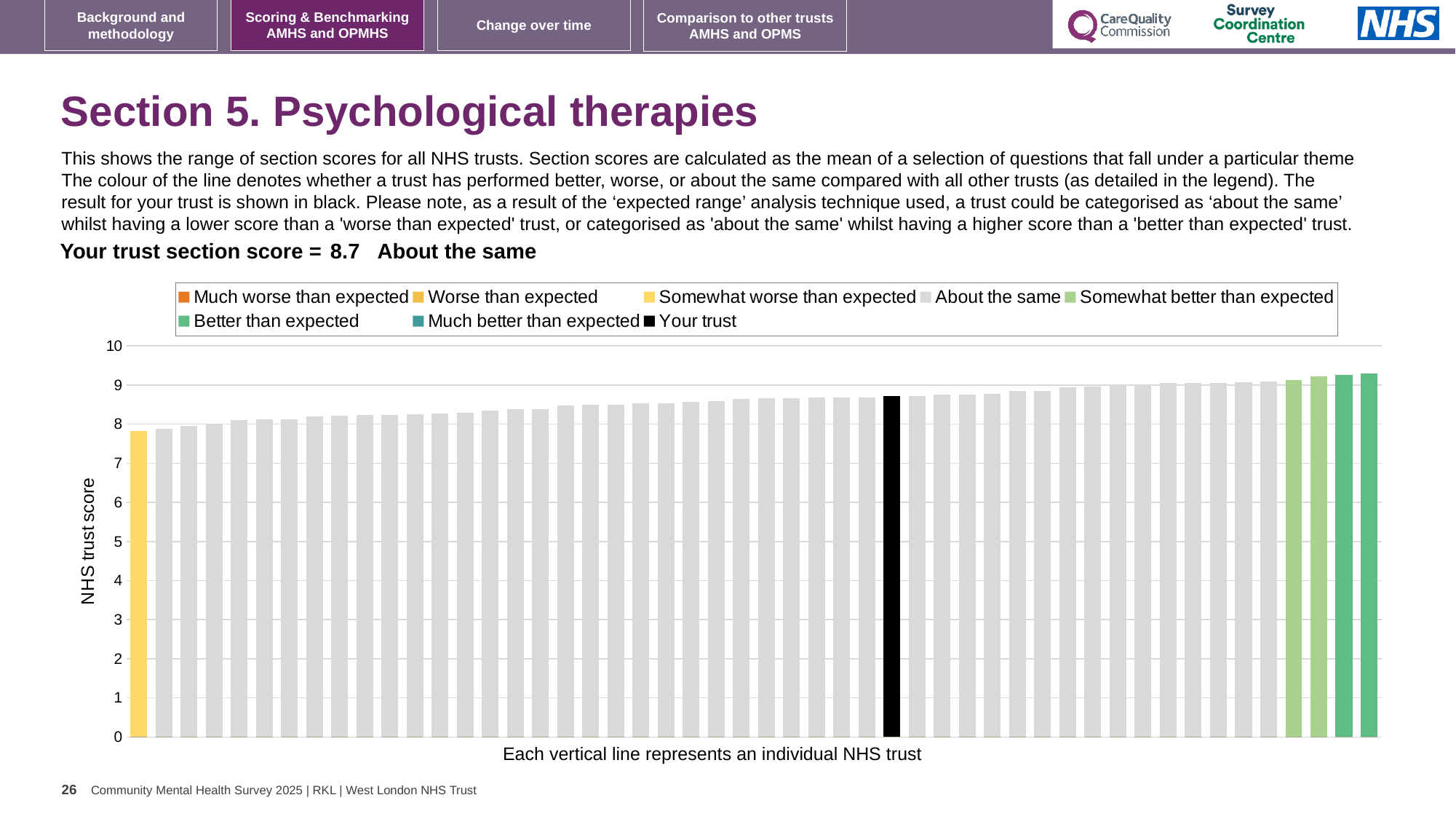
Which is larger: the black bar for your trust or the leftmost yellow bar? the black bar (your trust) What kind of chart is shown on the slide? bar chart How many entries does the chart legend list? 8 Do the bar values rise or fall from left to right across the chart? rise Is the value of the tallest bar in the chart greater or less than 9? greater What is the label on the vertical axis of the chart? NHS trust score How is your trust's section score categorised compared with other trusts? About the same What colour is the bar representing your trust in the chart? black Is the value of the black bar (your trust) greater or less than 8? greater Is the value of the leftmost (shortest) bar in the chart greater or less than 7? greater What is the section score for your trust shown on the slide? 8.7